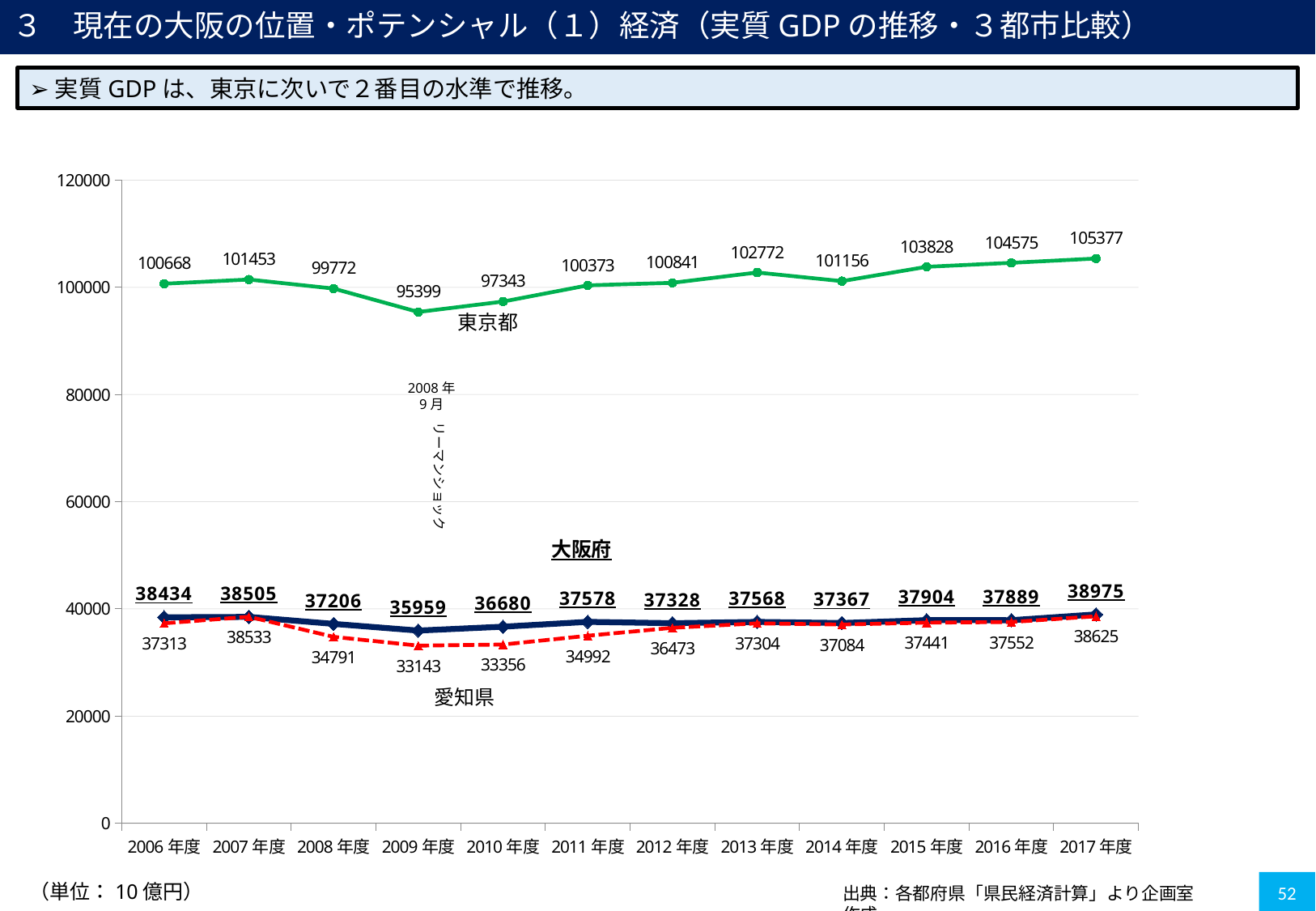
In which fiscal year is the value for 大阪府 lowest? 2009年度 What is the value for 愛知県 in 2010年度? 33356 What type of chart is shown on the slide? line chart What is the value for 東京都 in 2009年度? 95399 Does the value for 東京都 rise or fall from 2014年度 to 2017年度? rise Is the value for 東京都 in 2010年度 greater or less than 100000? less What is the difference between the 大阪府 and 愛知県 values in 2009年度? 2816 In which fiscal year is the value for 東京都 highest? 2017年度 What is the value for 大阪府 in 2017年度? 38975 How many lines (series) are plotted on the chart? 3 Which is larger in 2007年度, the value for 大阪府 or the value for 愛知県? 愛知県 How many fiscal years are shown on the x axis? 12